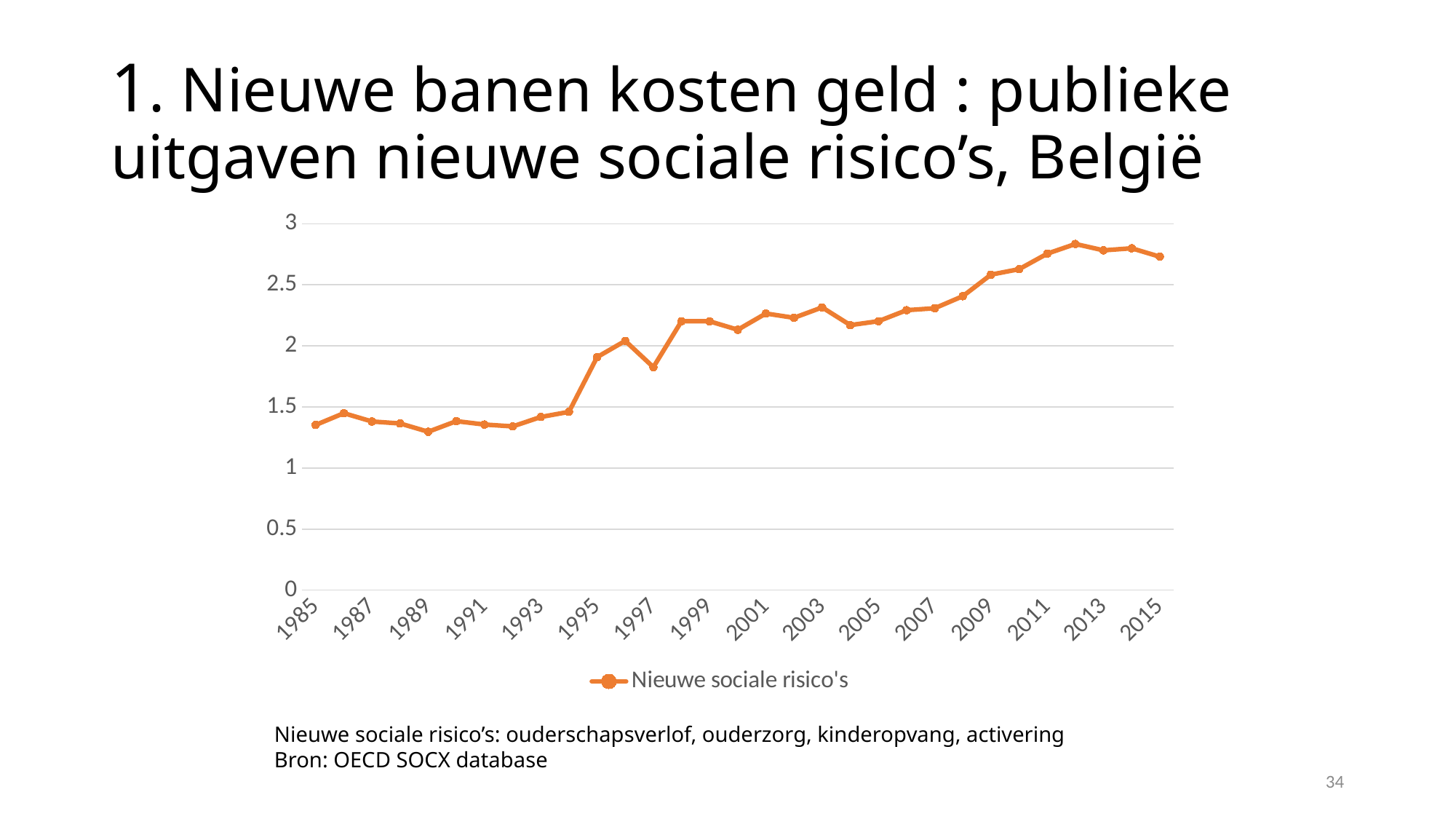
Is the value for 2012 greater or less than 2.5? greater How many series does the legend list? 1 Is the value for 2015 greater or less than 2.5? greater In which year does the series 'Nieuwe sociale risico's' reach its highest value? 2012 Is the value for 1997 greater or less than 2? less How many data points are plotted on the line from 1985 to 2015? 31 What is the name of the series shown in the legend? Nieuwe sociale risico's Which year has the larger value, 1997 or 1998? 1998 Do the values generally rise or fall from 1985 to 2015? rise What kind of chart is shown on the slide? line chart Which year has the larger value, 1985 or 1995? 1995